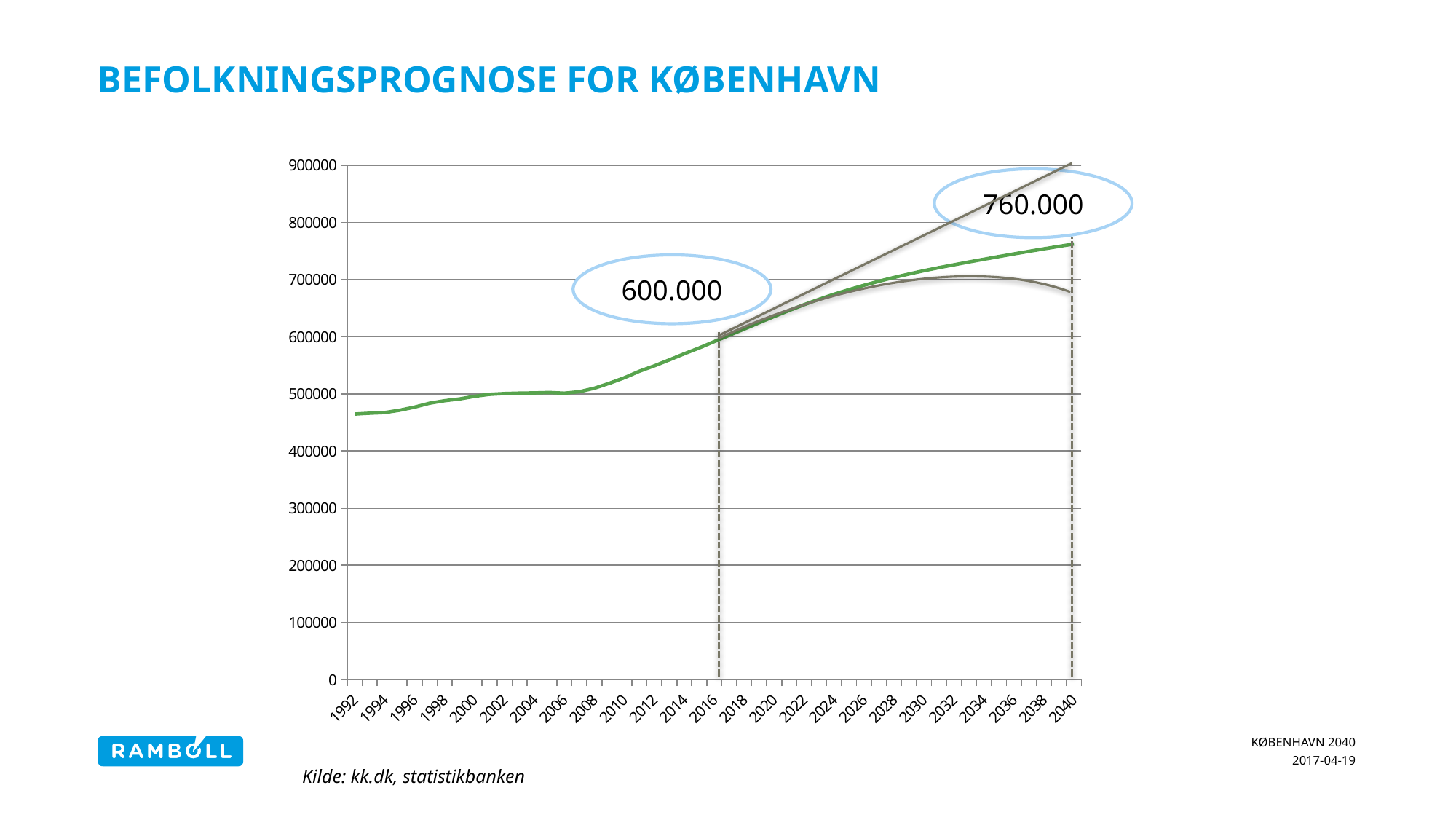
What is the difference between the two highlighted values, 760.000 and 600.000? 160.000 What population value is highlighted in the callout at the 2016 dashed line? 600.000 What kind of chart is shown on the slide? line chart Is the value of the green line in 1992 greater or less than 500000? less What is the first year shown on the x axis? 1992 What is the highest value shown on the y axis? 900000 What population value is highlighted in the callout at the 2040 dashed line? 760.000 Is the value of the green line in 2024 greater or less than 700000? less What is the title of the chart on the slide? BEFOLKNINGSPROGNOSE FOR KØBENHAVN Which highlighted value is larger, the one at 2016 or the one at 2040? 2040 Does the green line generally rise or fall from 1992 to 2040? rise Is the value of the green line in 2040 greater or less than 700000? greater